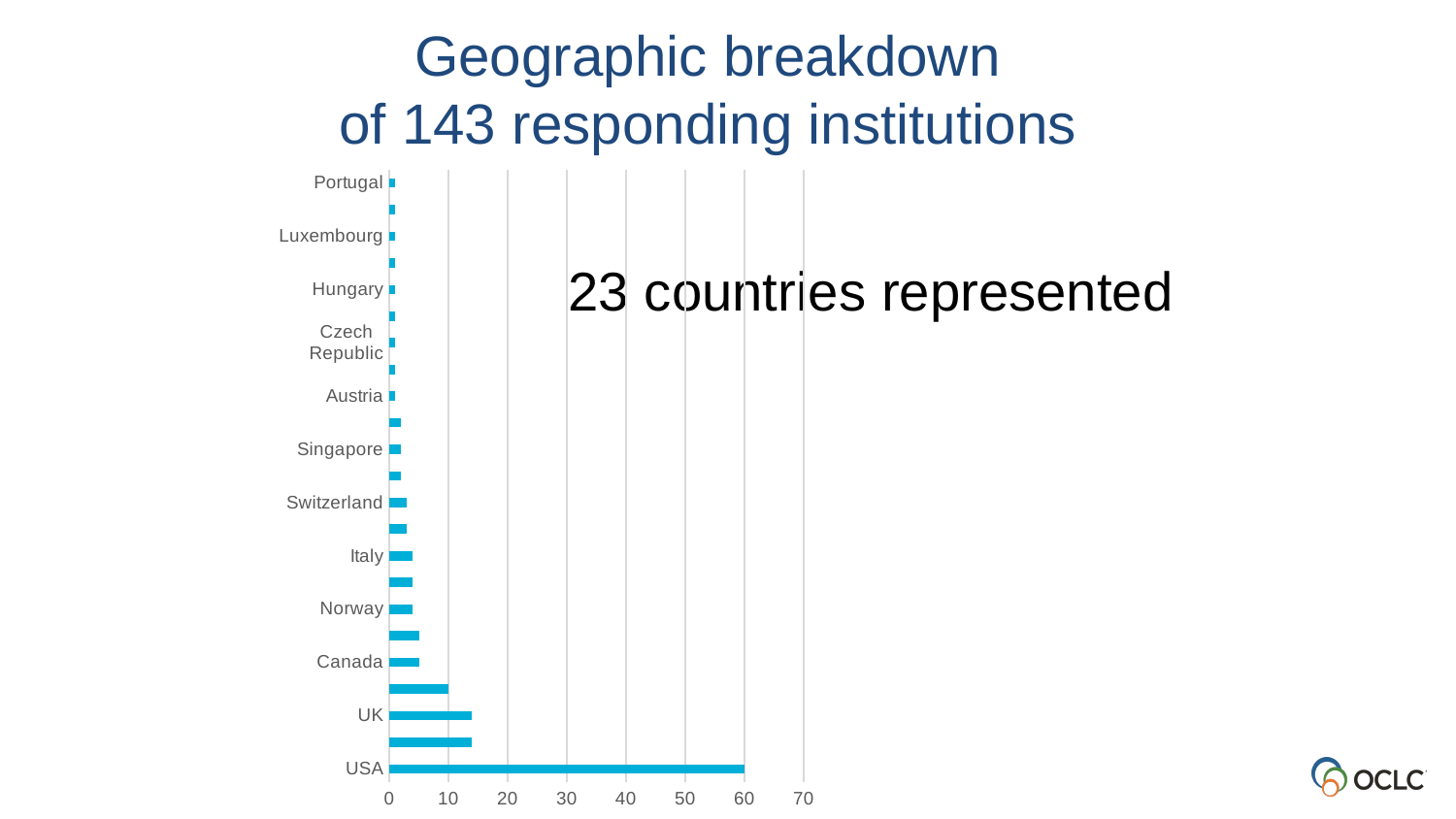
Which is larger, the value for UK or the value for Canada? UK What is the title of the slide? Geographic breakdown of 143 responding institutions Is the value for UK greater or less than 20? less How many countries are represented in the chart? 23 Which country has the highest number of responding institutions? USA What does the text next to the chart say? 23 countries represented What kind of chart is shown on the slide? bar chart Which is larger, the value for Norway or the value for Singapore? Norway Is the value for Canada greater or less than 10? less Is the value for UK greater or less than 10? greater What is the value for USA? 60